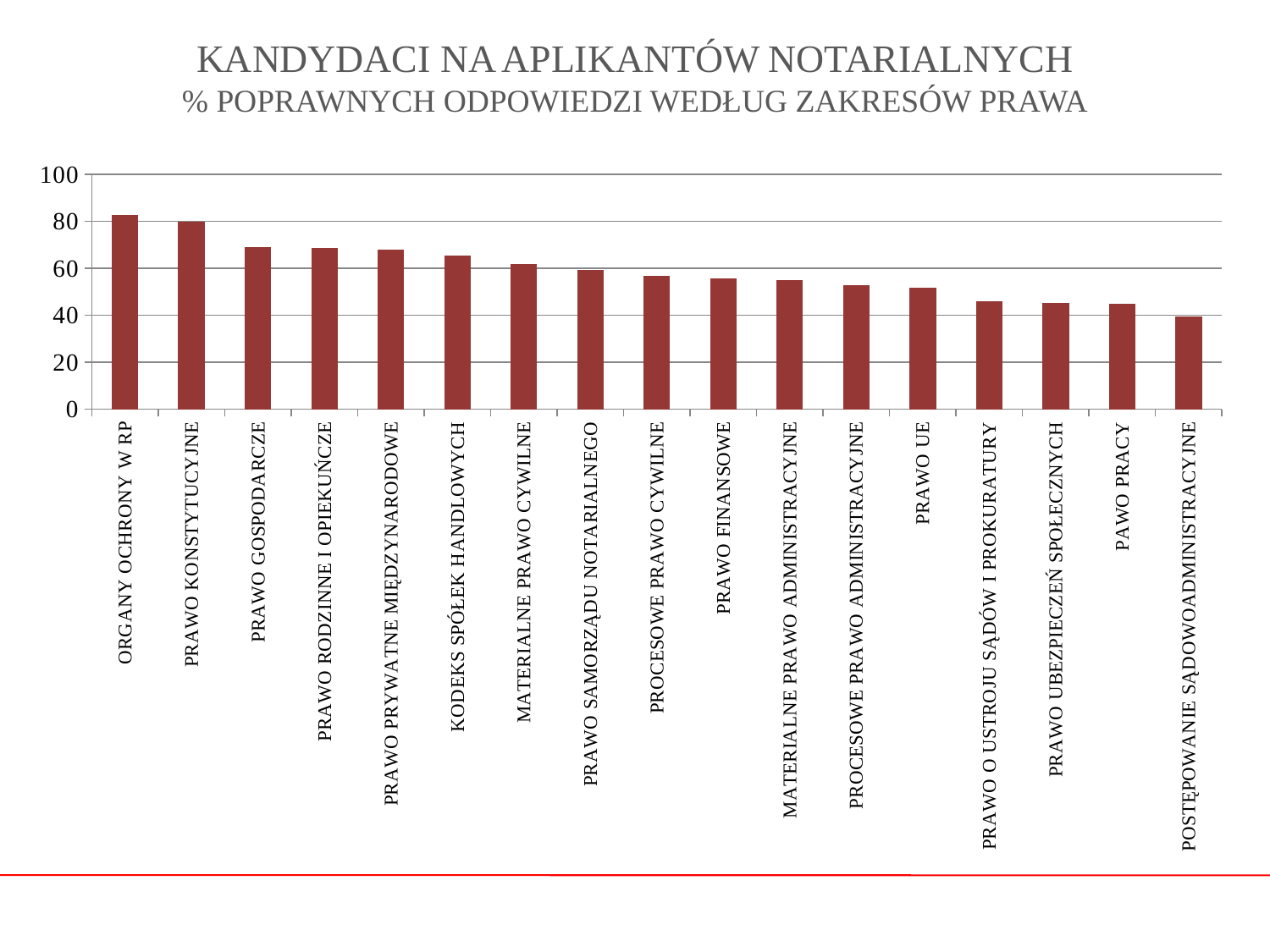
Is the value for ORGANY OCHRONY W RP greater or less than 80? greater What kind of chart is shown on the slide? bar chart What is the main title of the chart on the slide? KANDYDACI NA APLIKANTÓW NOTARIALNYCH Which is larger, the value for PRAWO GOSPODARCZE or the value for PRAWO UE? PRAWO GOSPODARCZE Is the value for PRAWO O USTROJU SĄDÓW I PROKURATURY greater or less than 40? greater Is the value for PRAWO UE greater or less than 60? less Which category has the lowest value? POSTĘPOWANIE SĄDOWOADMINISTRACYJNE Which category has the highest value? ORGANY OCHRONY W RP How many categories (areas of law) are shown on the chart? 17 Do the values rise or fall from left to right along the x axis? fall